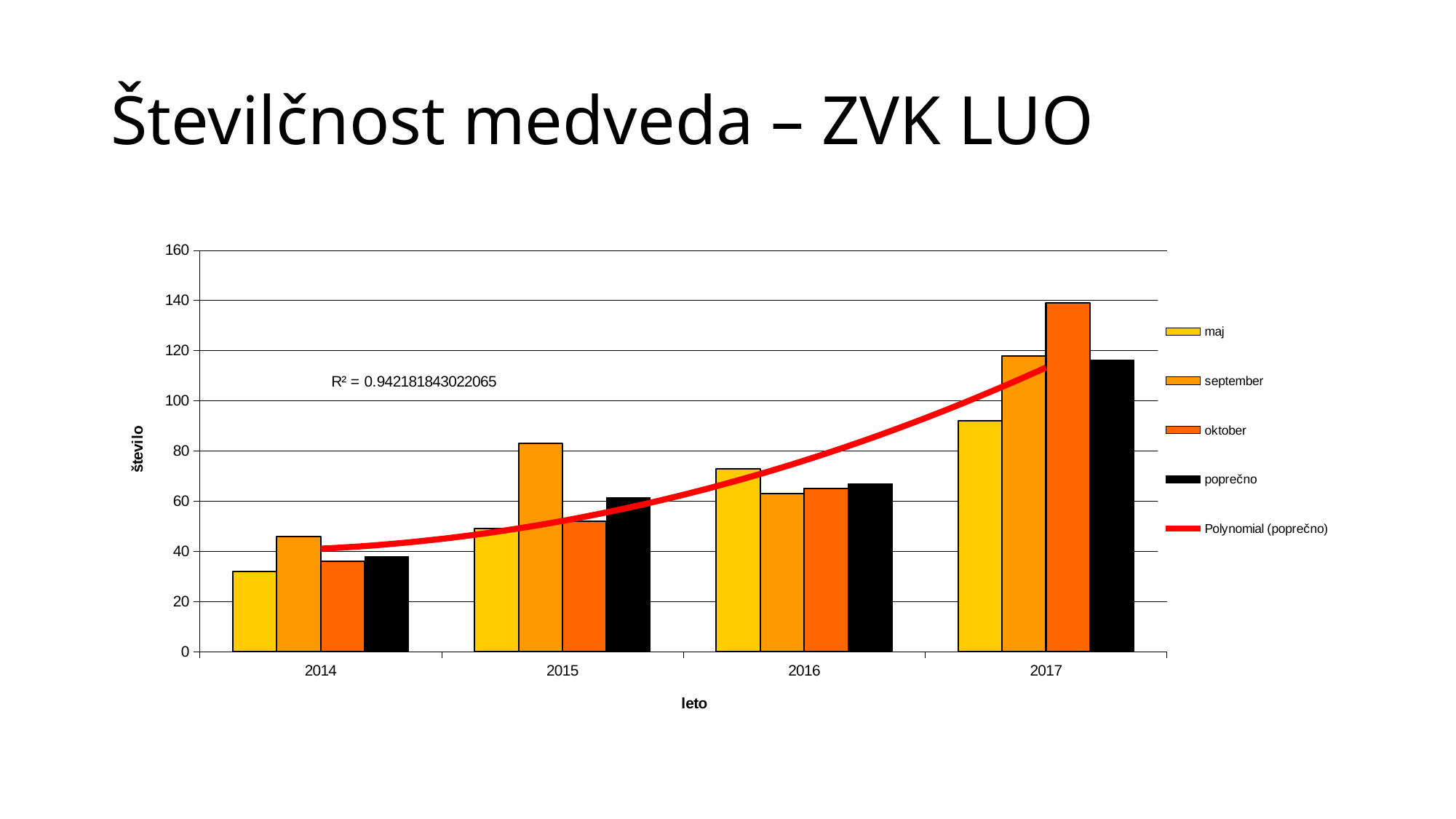
Is the value for maj in 2014 greater or less than 40? less Is the value for poprečno in 2017 greater or less than 100? greater Does the poprečno series rise or fall from 2014 to 2017? rise What kind of chart is shown on the slide? bar chart How many years are shown on the x axis of the chart? 4 In which year is the oktober bar the highest? 2017 In which year is the maj bar the lowest? 2014 Is the value for maj in 2016 greater or less than 60? greater In 2015, which is larger: the maj bar or the september bar? september What R² value is printed on the chart? 0.942181843022065 How many entries does the chart's legend list? 5